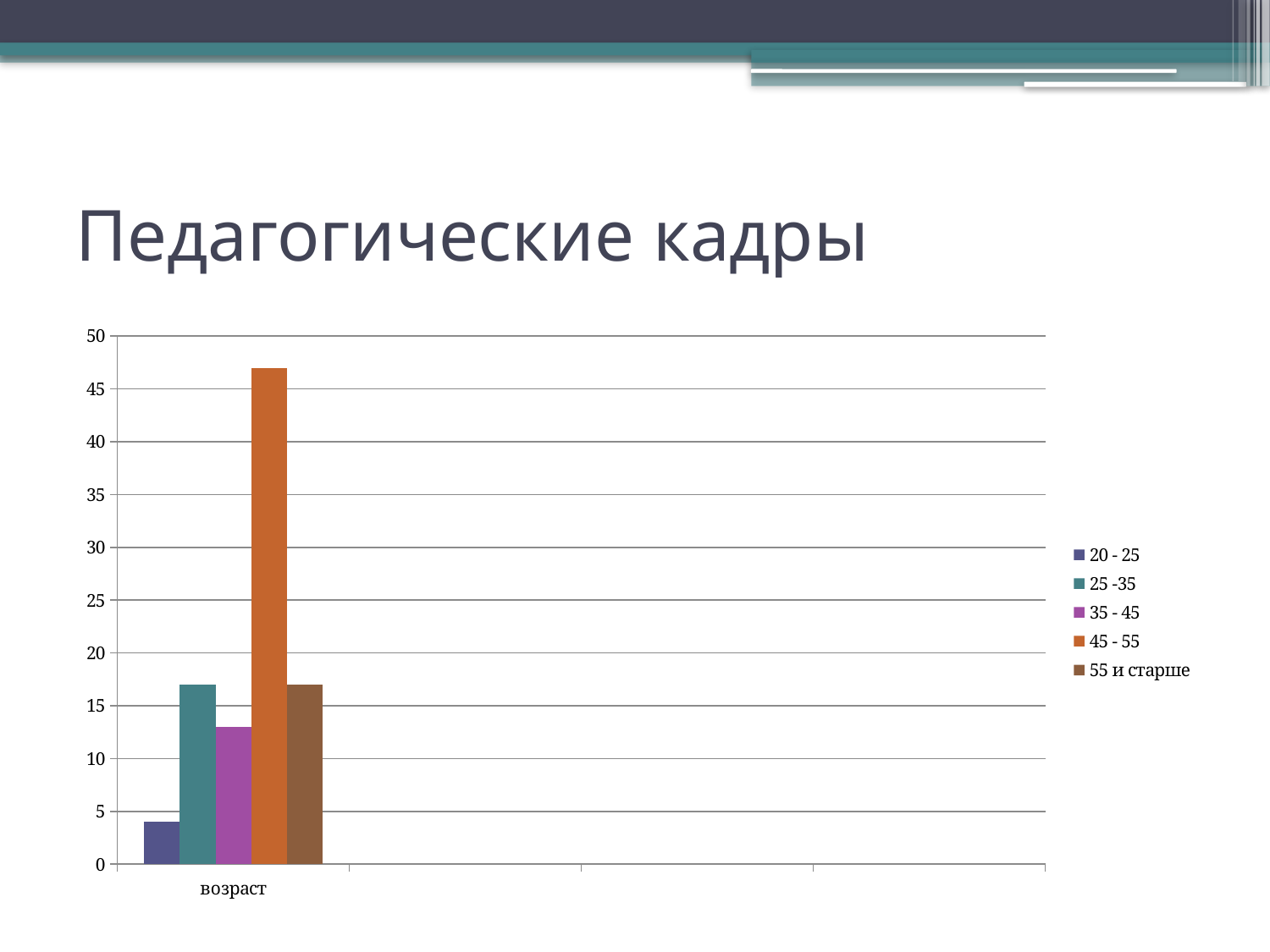
Is the value for the 20 - 25 group greater or less than 5? less Is the value for the 55 и старше group greater or less than 20? less What kind of chart is shown on the slide? bar chart Which is larger, the value for 45 - 55 or the value for 55 и старше? 45 - 55 How many series does the legend list? 5 Which age group has the highest bar? 45 - 55 What is the label of the category on the x axis? возраст Which is larger, the value for 25 -35 or the value for 35 - 45? 25 -35 Is the value for the 35 - 45 group greater or less than 10? greater Which age group has the lowest bar? 20 - 25 How many categories are shown on the x axis? 1